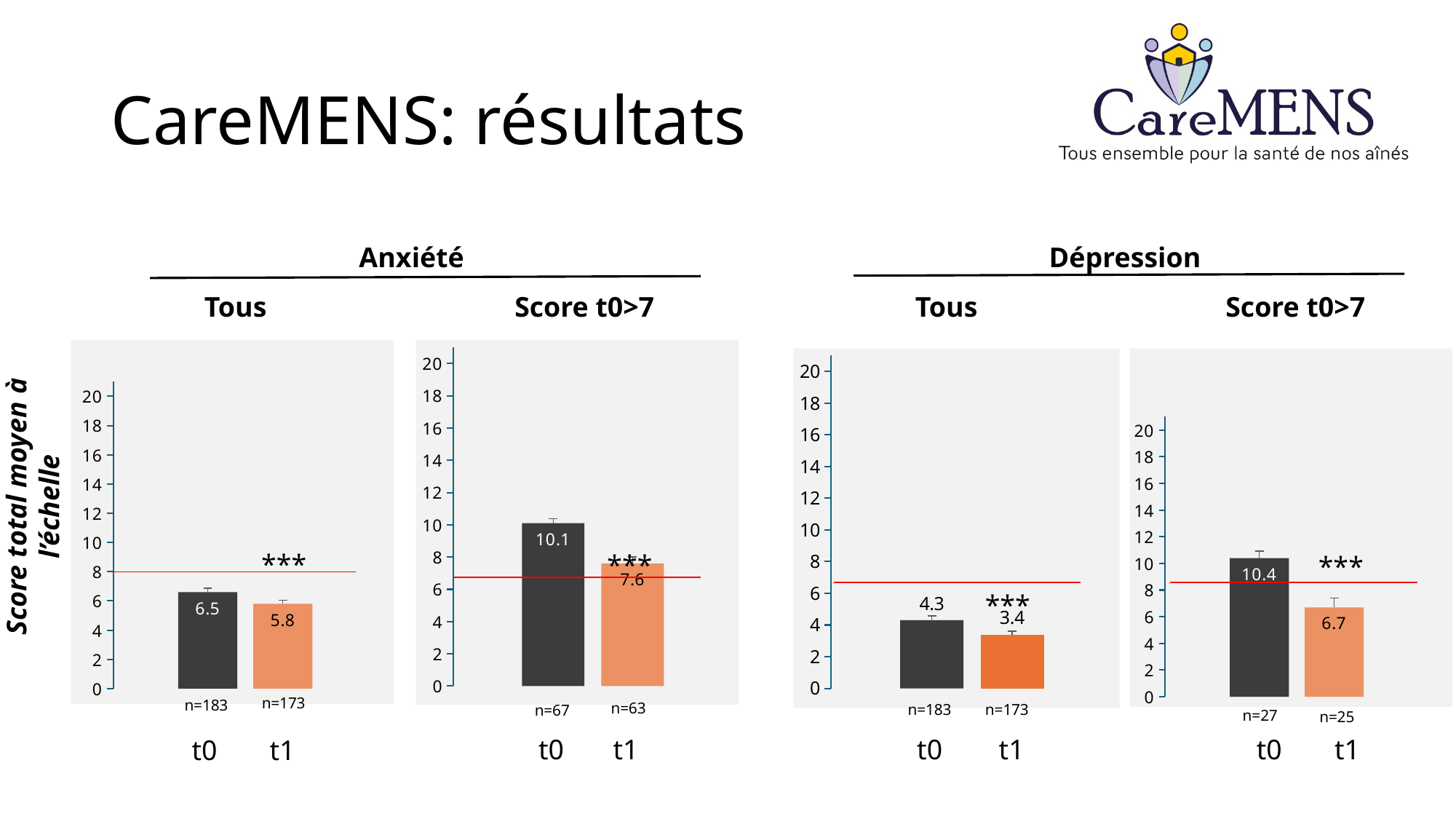
In the Dépression 'Tous' chart, what is the value for t1? 3.4 In the Anxiété 'Score t0>7' chart, what is the value for t0? 10.1 In the Anxiété 'Score t0>7' chart, what is the difference between the t0 and t1 values? 2.5 In the Anxiété 'Tous' chart, what is the value for t0? 6.5 In the Dépression 'Score t0>7' chart, is the value for t1 greater or less than 8? less In the Dépression 'Tous' chart, which is larger, t0 or t1? t0 How many bars are in the Dépression 'Tous' chart? 2 In the Dépression 'Score t0>7' chart, what is the difference between the t0 and t1 values? 3.7 What kind of chart is the Anxiété 'Tous' chart? bar chart In the Anxiété 'Tous' chart, what is the value for t1? 5.8 In the Dépression 'Score t0>7' chart, what is the value for t0? 10.4 In the Anxiété 'Score t0>7' chart, do the values rise or fall from t0 to t1? fall